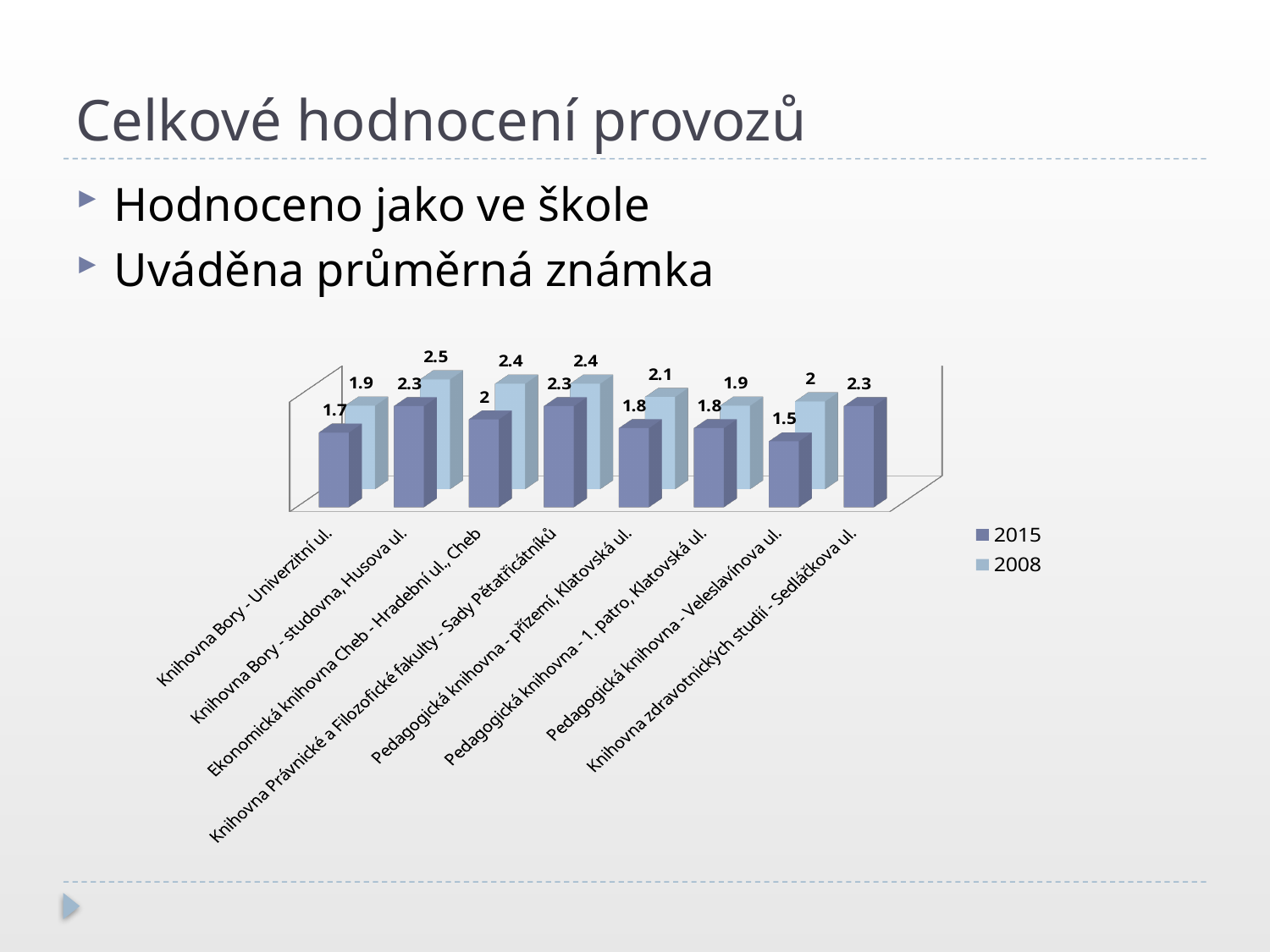
What is the 2015 value for Ekonomická knihovna Cheb - Hradební ul., Cheb? 2 Which library has the highest 2008 value? Knihovna Bory - studovna, Husova ul. What is the 2015 value for Knihovna Bory - Univerzitní ul.? 1.7 For Ekonomická knihovna Cheb - Hradební ul., Cheb, which is larger: the 2015 value or the 2008 value? 2008 How many library locations (categories) are shown on the x axis of the chart? 8 What type of chart is shown on the slide? bar chart How many series does the chart legend list? 2 Which library has the lowest 2015 value? Pedagogická knihovna - Veleslavínova ul. What is the difference between the 2008 and 2015 values for Pedagogická knihovna - Veleslavínova ul.? 0.5 What is the 2008 value for Knihovna Bory - studovna, Husova ul.? 2.5 Which years are listed in the chart legend? 2015 and 2008 What is the 2008 value for Pedagogická knihovna - přízemí, Klatovská ul.? 2.1